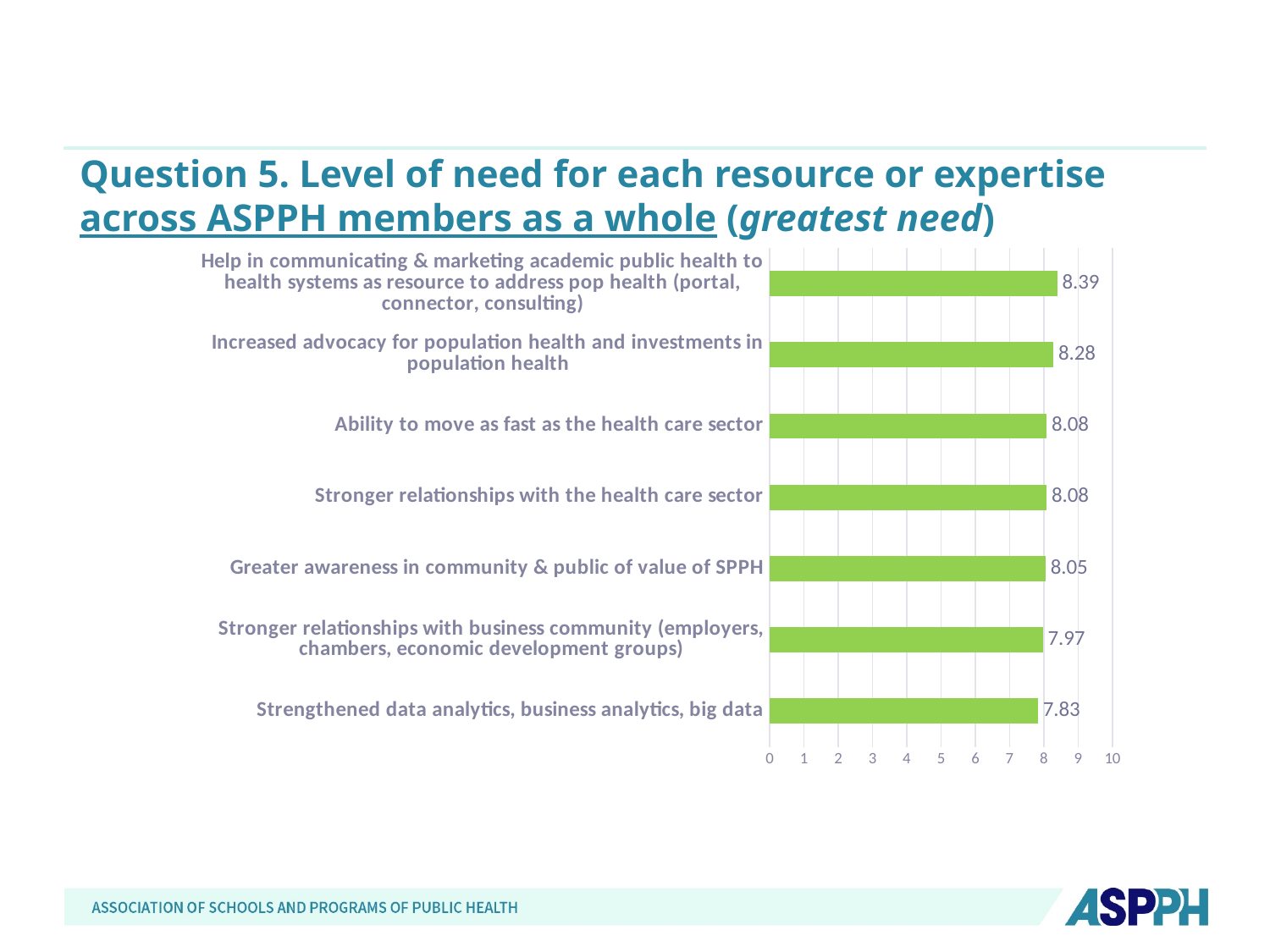
What is the difference between the highest value (8.39) and the lowest value (7.83)? 0.56 What kind of chart is shown on the slide? Bar chart Is the value for "Stronger relationships with the health care sector" greater or less than 8? greater What is the maximum value shown on the horizontal axis? 10 What is the value for "Increased advocacy for population health and investments in population health"? 8.28 What is the value for "Ability to move as fast as the health care sector"? 8.08 What is the value for "Strengthened data analytics, business analytics, big data"? 7.83 What is the value for "Greater awareness in community & public of value of SPPH"? 8.05 How many categories are shown in the chart? 7 Which category has the lowest value? Strengthened data analytics, business analytics, big data Which category has the highest value? Help in communicating & marketing academic public health to health systems as resource to address pop health (portal, connector, consulting) Which is larger: the value for "Increased advocacy for population health and investments in population health" or the value for "Stronger relationships with business community (employers, chambers, economic development groups)"? Increased advocacy for population health and investments in population health